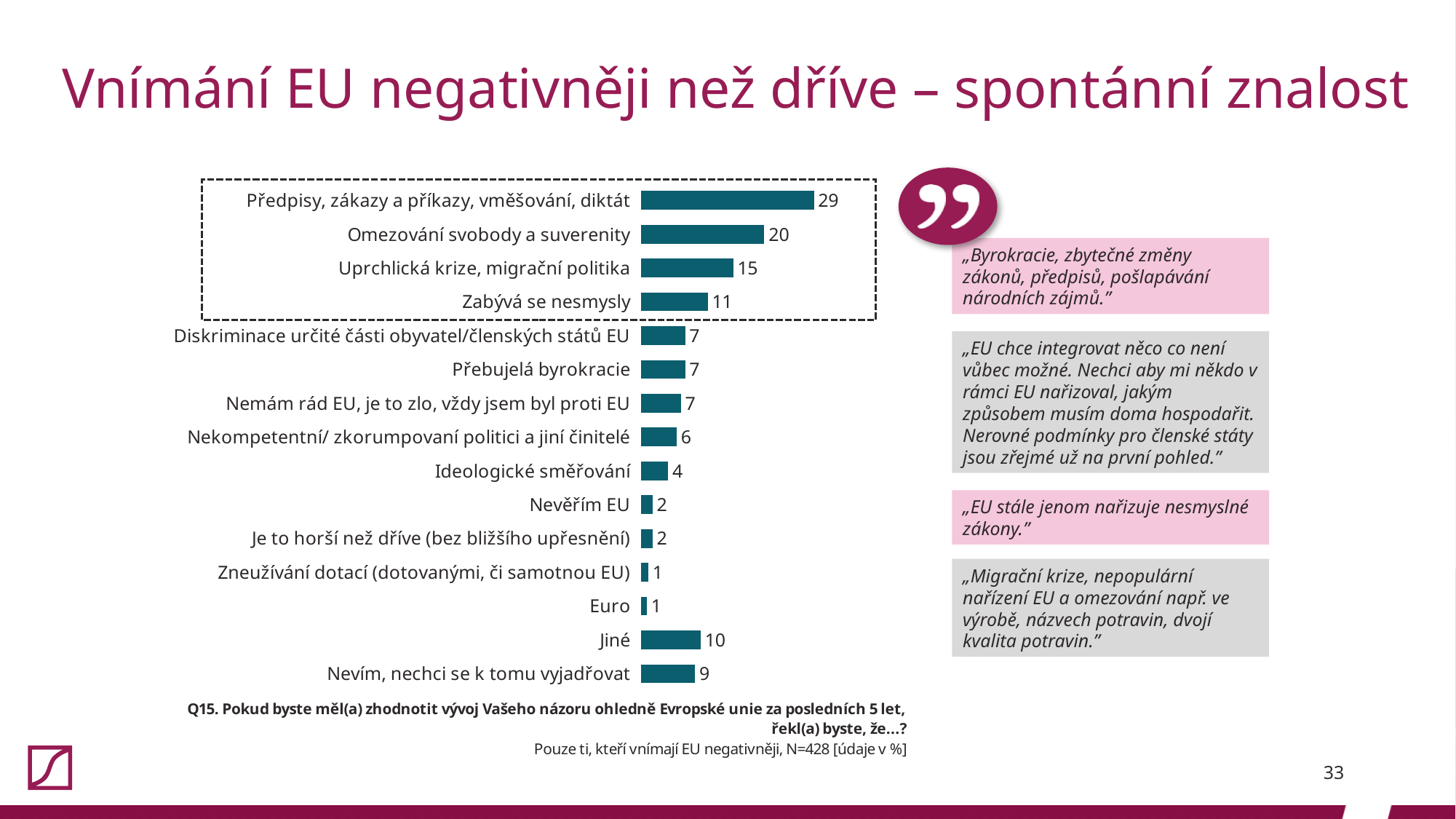
Which is larger, the value for "Omezování svobody a suverenity" or the value for "Uprchlická krize, migrační politika"? Omezování svobody a suverenity How many categories are shown in the chart? 15 What is the value for "Uprchlická krize, migrační politika"? 15 What is the value for "Jiné"? 10 How many categories are enclosed in the dashed box at the top of the chart? 4 What kind of chart is shown on the slide? Bar chart What is the value for "Ideologické směřování"? 4 What is the value for "Předpisy, zákazy a příkazy, vměšování, diktát"? 29 Which is larger, the value for "Jiné" or the value for "Nevím, nechci se k tomu vyjadřovat"? Jiné Which category has the highest value? Předpisy, zákazy a příkazy, vměšování, diktát What is the difference between the values for "Předpisy, zákazy a příkazy, vměšování, diktát" and "Omezování svobody a suverenity"? 9 What is the difference between the values for "Zabývá se nesmysly" and "Nevěřím EU"? 9